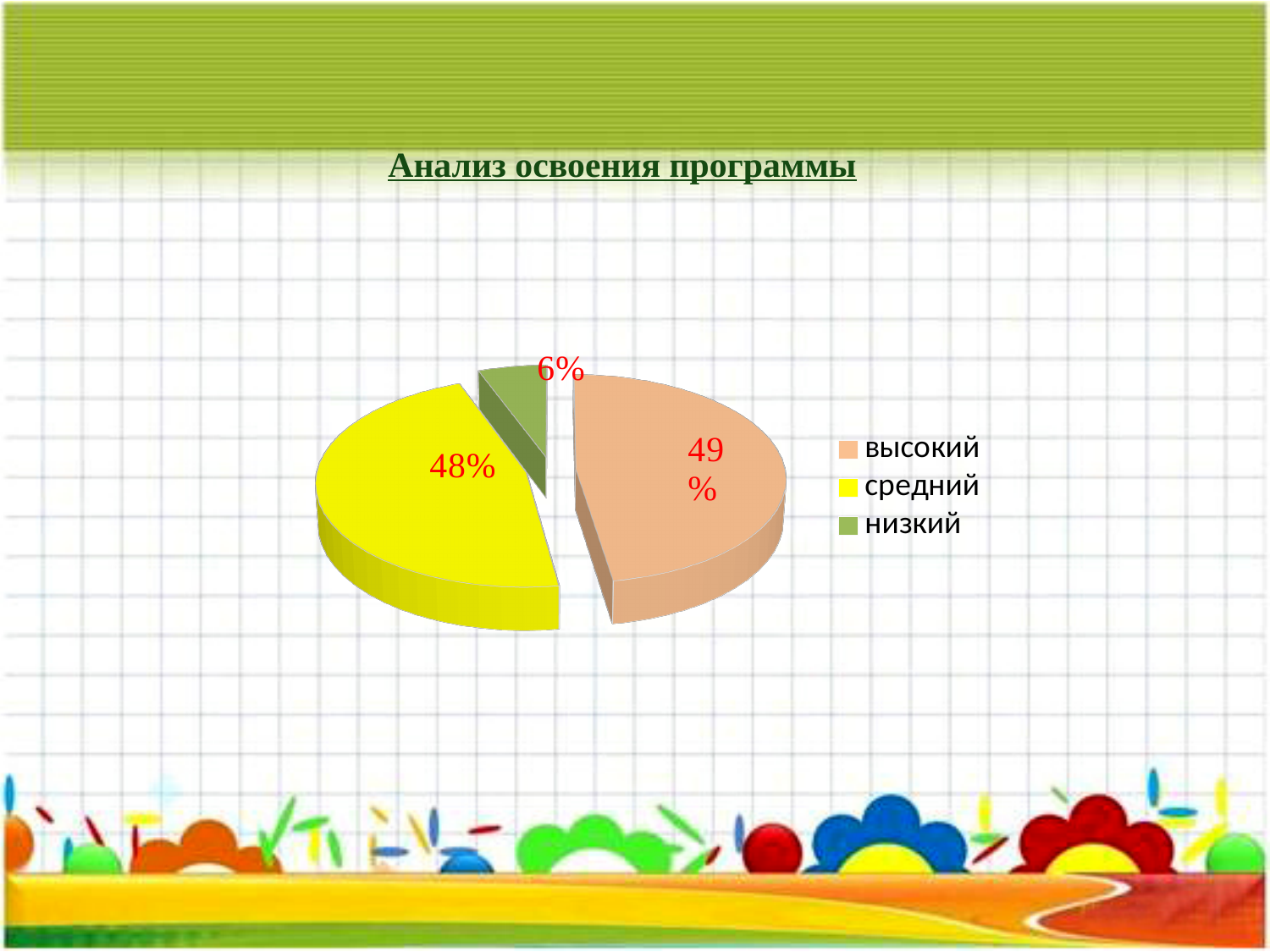
What is the share for высокий? 49% Which is larger, the share for высокий or the share for низкий? высокий What is the share for средний? 48% What is the difference between the shares for средний and низкий? 42% How many slices does the pie chart have? 3 What kind of chart is shown on the slide? pie chart Which category has the largest slice of the pie? высокий What is the difference between the shares for высокий and средний? 1% Which category has the smallest slice of the pie? низкий What is the share for низкий? 6% How many entries does the legend list? 3 What is the title of the slide above the chart? Анализ освоения программы